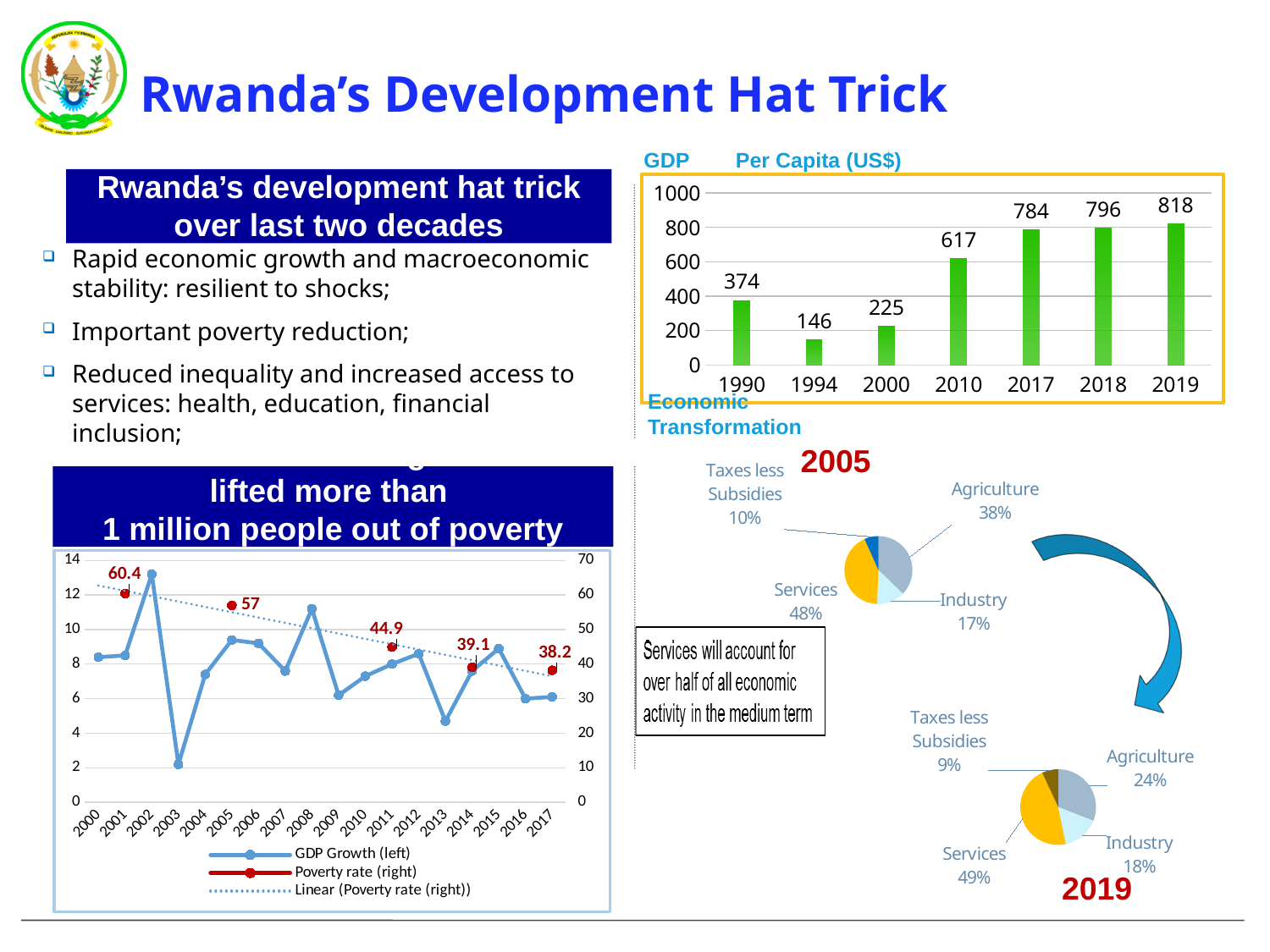
In the 2005 pie chart, what share does Services account for? 48% In the GDP Growth and Poverty rate line chart, what is the poverty rate labelled for 2011? 44.9 In the 2019 pie chart, which sector has the largest share? Services In the GDP Growth and Poverty rate line chart, how many series does the legend list? 3 In the GDP Per Capita (US$) bar chart, how many years are shown? 7 In the GDP Per Capita (US$) bar chart, which year has the lowest value? 1994 In the GDP Per Capita (US$) bar chart, which year has the highest value? 2019 What kind of chart is the GDP Per Capita (US$) chart? Bar chart In the GDP Per Capita (US$) bar chart, what is the value for 2010? 617 In the GDP Growth and Poverty rate line chart, does the poverty rate rise or fall from 2000 to 2017? Fall In the GDP Per Capita (US$) bar chart, what is the difference between the 2019 and 1990 values? 444 Is Agriculture's share larger in the 2005 pie chart or the 2019 pie chart? 2005